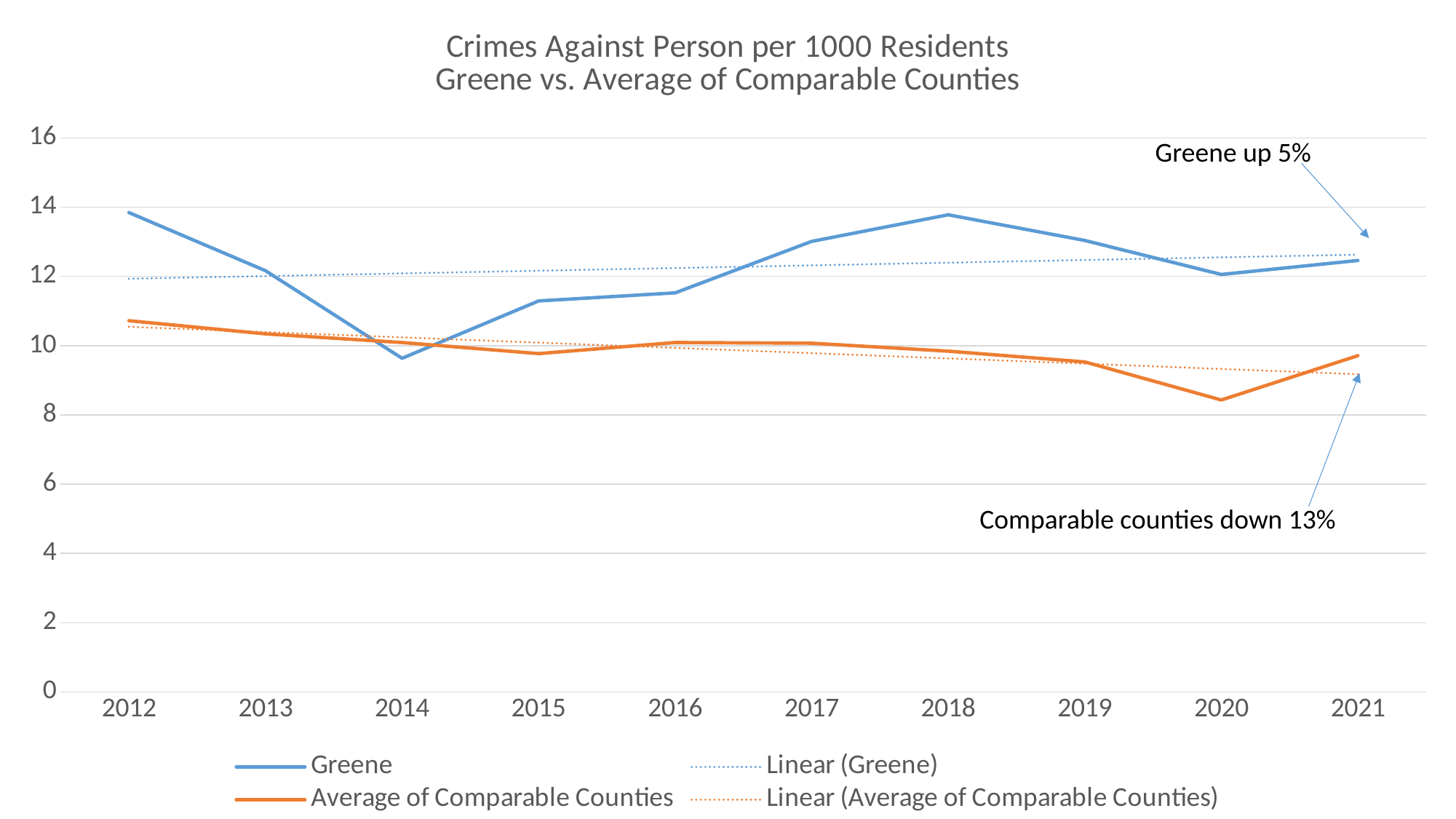
How many years are shown on the x axis? 10 Is the value for Greene in 2014 greater or less than 10? less In which year is the Average of Comparable Counties line at its lowest? 2020 Is the value for Greene in 2012 greater or less than 12? greater Is the value for Average of Comparable Counties in 2020 greater or less than 10? less What kind of chart is shown on the slide? line chart Does the Average of Comparable Counties line generally rise or fall from 2012 to 2020? fall In which year is the Average of Comparable Counties line at its highest? 2012 How many series does the legend list? 4 According to the annotation on the chart, by what percentage did comparable counties go down? 13% In which year is the Greene line at its lowest? 2014 In 2014, which is higher: Greene or Average of Comparable Counties? Average of Comparable Counties